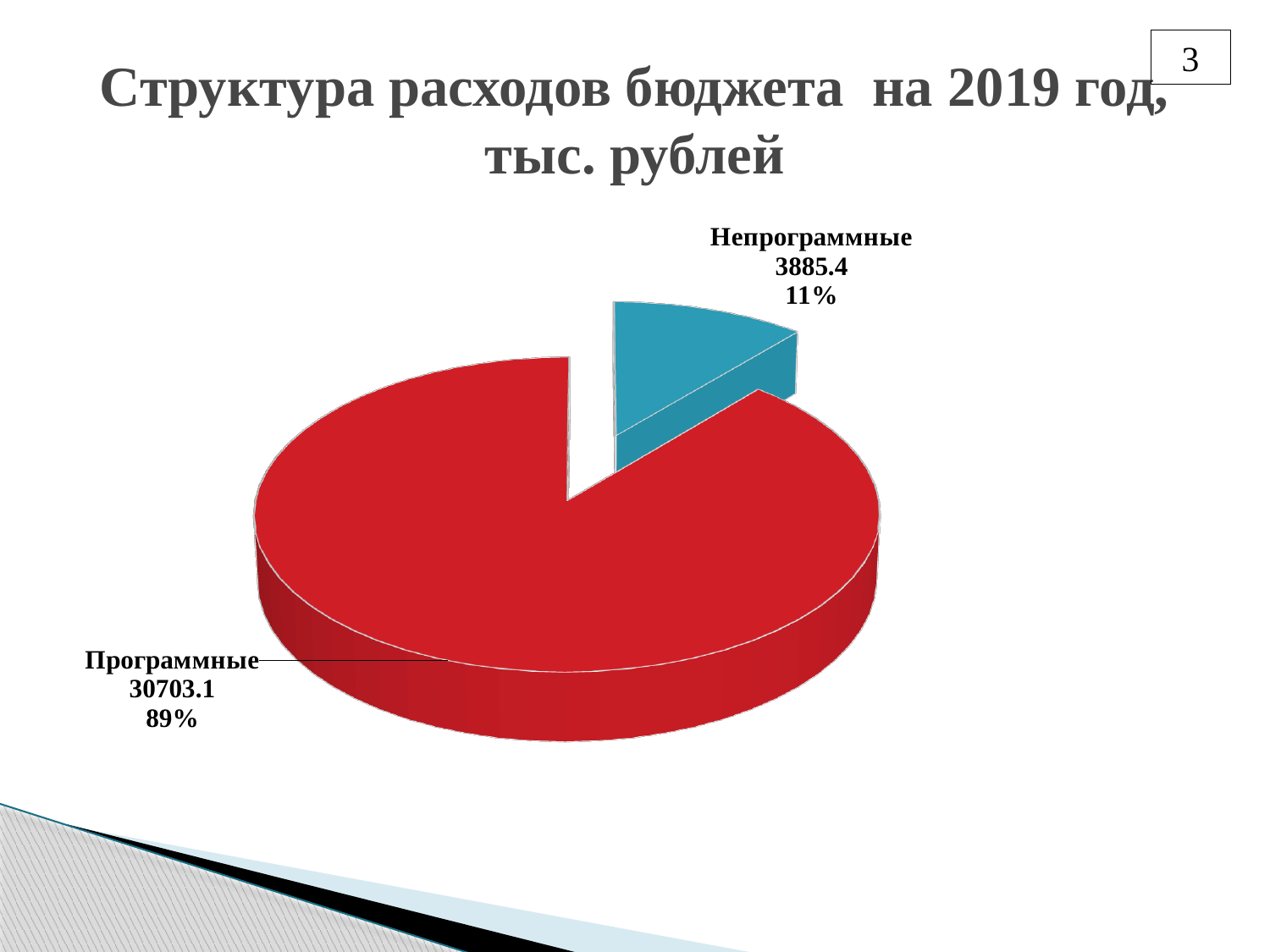
What colour is the slice for Непрограммные? blue What is the title of the chart? Структура расходов бюджета на 2019 год, тыс. рублей What share of the pie does Непрограммные represent? 11% What kind of chart is shown on the slide? pie chart What is the value for Программные? 30703.1 Which is larger, Программные or Непрограммные? Программные What is the difference between the values for Программные and Непрограммные? 26817.7 What share of the pie does Программные represent? 89% What is the value for Непрограммные? 3885.4 Which category has the largest slice? Программные How many slices does the pie chart have? 2 Which category has the smallest slice? Непрограммные